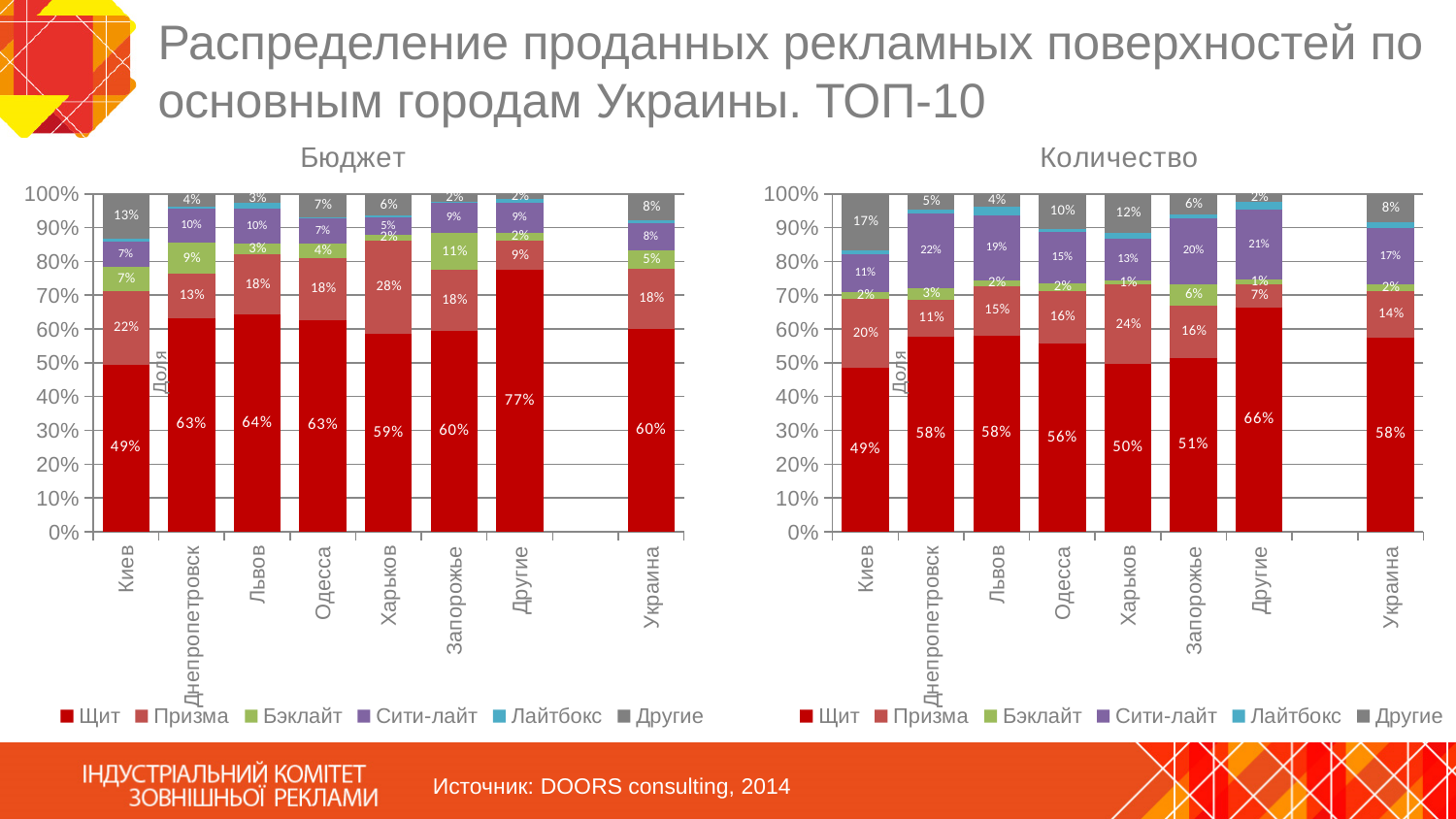
In the Бюджет chart, which category has the highest Щит value? Другие In the Количество chart, which is larger: the Призма value for Харьков or for Киев? Харьков How many series does the legend of the Бюджет chart list? 6 In the Бюджет chart, what is the value of Щит for Киев? 49% In the Количество chart, what is the value of the Другие series for Киев? 17% In the Бюджет chart, what is the value of Призма for Харьков? 28% How many categories are shown on the x axis of the Количество chart? 8 In the Бюджет chart, what is the difference between the Щит values for Другие and Киев? 28% What type of chart is the Бюджет chart? Stacked bar chart In the Количество chart, which category has the lowest Щит value? Киев In the Количество chart, what is the value of Щит for Другие? 66% In the Количество chart, what is the value of Сити-лайт for Днепропетровск? 22%